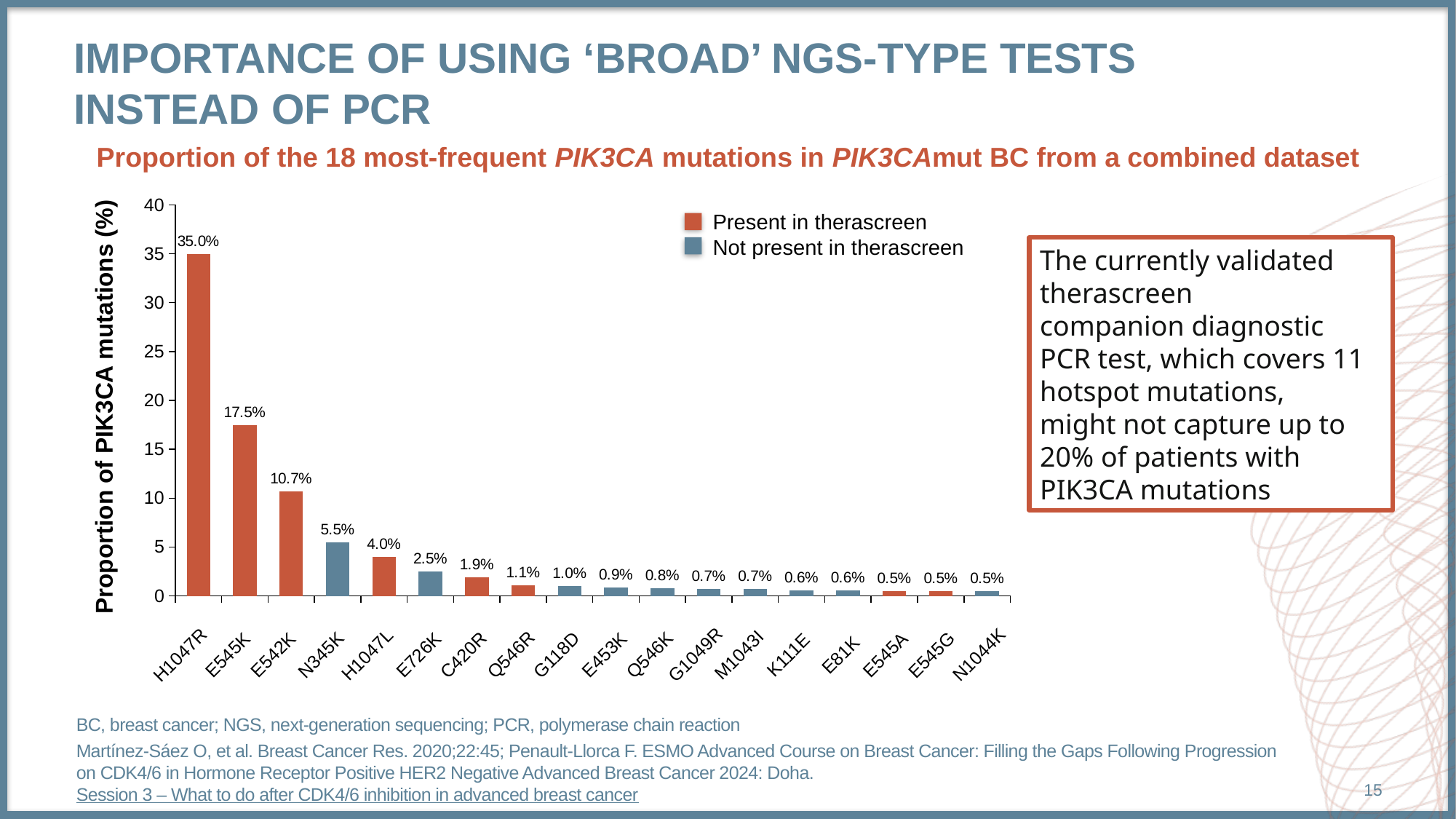
What is the value for H1047R? 35.0% What is the value for E542K? 10.7% Do the values rise or fall from left to right along the x axis? fall Which is larger, the value for N345K or the value for H1047L? N345K How many mutations are shown on the x axis? 18 How many entries does the legend list? 2 Which mutation has the highest proportion? H1047R What is the value for E726K? 2.5% What is the value for N345K? 5.5% Is the value for E545K greater or less than 15? greater What is the difference between the values for H1047R and E545K? 17.5% What kind of chart is shown? bar chart